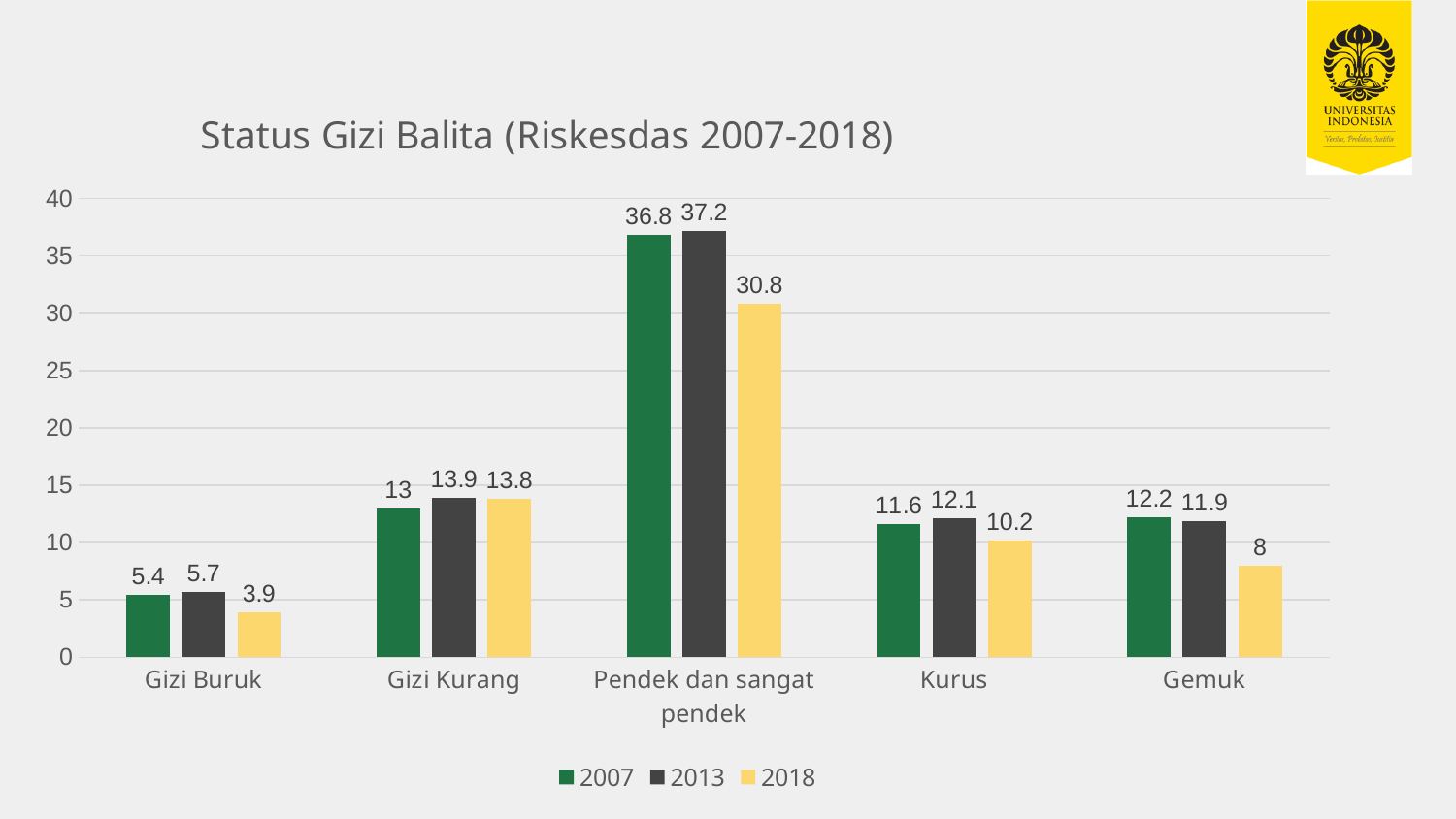
What is the value for Gemuk in 2018? 8 What is the value for Gizi Buruk in 2018? 3.9 Which is larger for Kurus: the 2007 value or the 2018 value? 2007 Is the value for Gizi Kurang in 2013 greater or less than 10? greater How many categories are shown on the x axis? 5 How many series does the legend list? 3 Which category has the highest value in 2007? Pendek dan sangat pendek What is the title of the chart? Status Gizi Balita (Riskesdas 2007-2018) What is the difference between the 2013 and 2018 values for Pendek dan sangat pendek? 6.4 What kind of chart is shown on the slide? Bar chart What is the value for Pendek dan sangat pendek in 2013? 37.2 Which category has the lowest value in 2018? Gizi Buruk